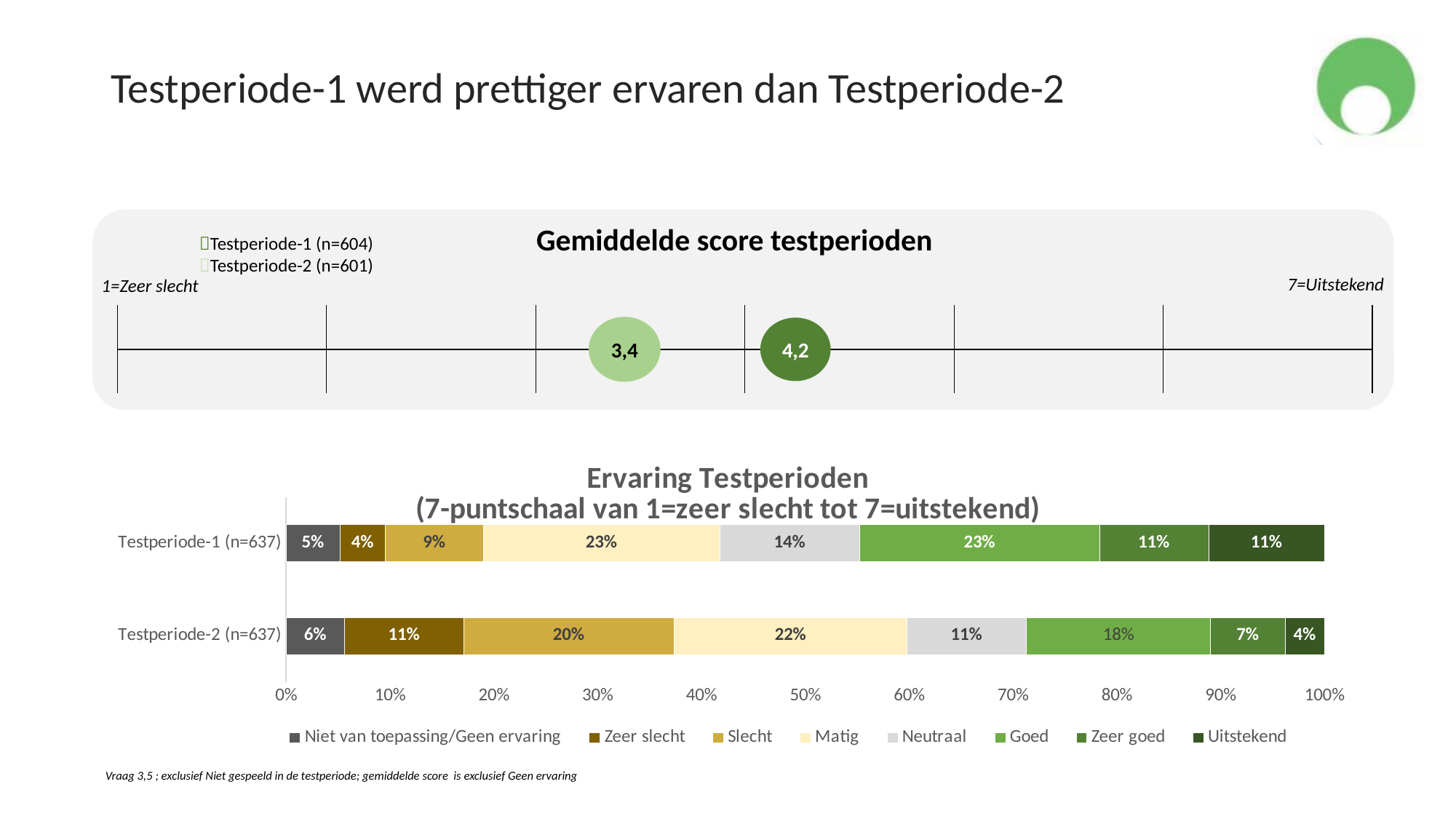
In the 'Ervaring Testperioden' chart, what is the difference between the 'Uitstekend' shares of Testperiode-1 and Testperiode-2? 7% In the 'Ervaring Testperioden' chart, what percentage of Testperiode-1 respondents answered 'Matig'? 23% What kind of chart is 'Ervaring Testperioden'? Stacked bar chart In the 'Ervaring Testperioden' chart, what percentage of Testperiode-2 respondents answered 'Uitstekend'? 4% In the 'Gemiddelde score testperioden' chart, what is the difference between the average scores of Testperiode-1 and Testperiode-2? 0,8 In the 'Gemiddelde score testperioden' chart, which test period has the higher average score? Testperiode-1 In the 'Ervaring Testperioden' chart, what is the combined share of 'Goed', 'Zeer goed' and 'Uitstekend' for Testperiode-1? 45% In the 'Ervaring Testperioden' chart, which test period has the larger share of 'Zeer slecht' responses? Testperiode-2 In the 'Ervaring Testperioden' chart, what percentage of Testperiode-2 respondents answered 'Slecht'? 20% In the 'Gemiddelde score testperioden' chart, what is the average score for Testperiode-1? 4,2 How many series does the legend of the 'Ervaring Testperioden' chart list? 8 In the 'Gemiddelde score testperioden' chart, what is the average score for Testperiode-2? 3,4